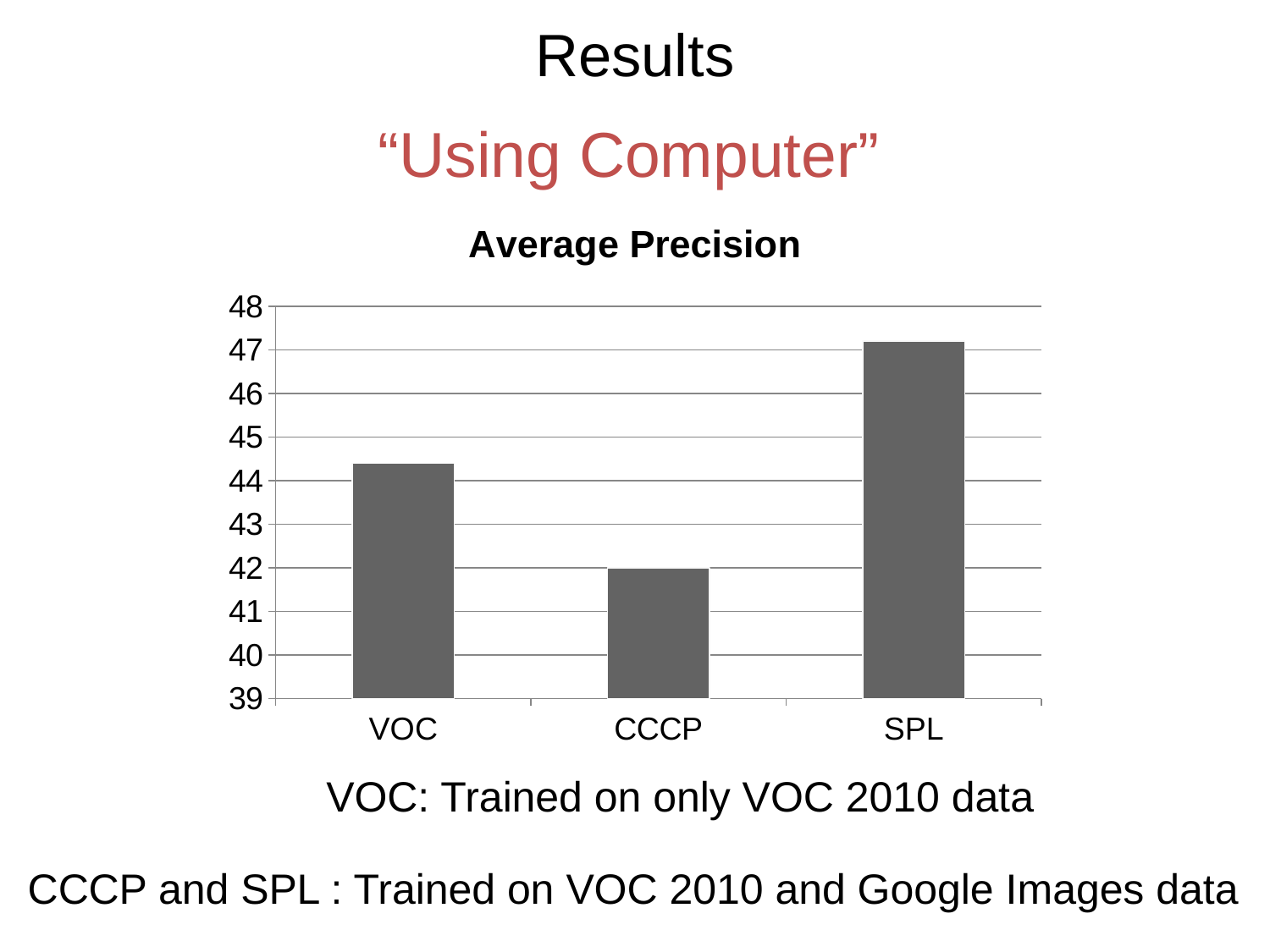
Which has a higher average precision, SPL or VOC? SPL Is the value for SPL greater or less than 46? greater Which category has the highest average precision? SPL What is the title of the chart? Average Precision Is the value for VOC greater or less than 44? greater What is the lowest value shown on the vertical axis? 39 What type of chart is shown on the slide? bar chart Is the value for CCCP greater or less than 43? less Which has a higher average precision, VOC or CCCP? VOC Does the average precision rise or fall from VOC to CCCP? fall Which category has the lowest average precision? CCCP How many categories are plotted in the chart? 3